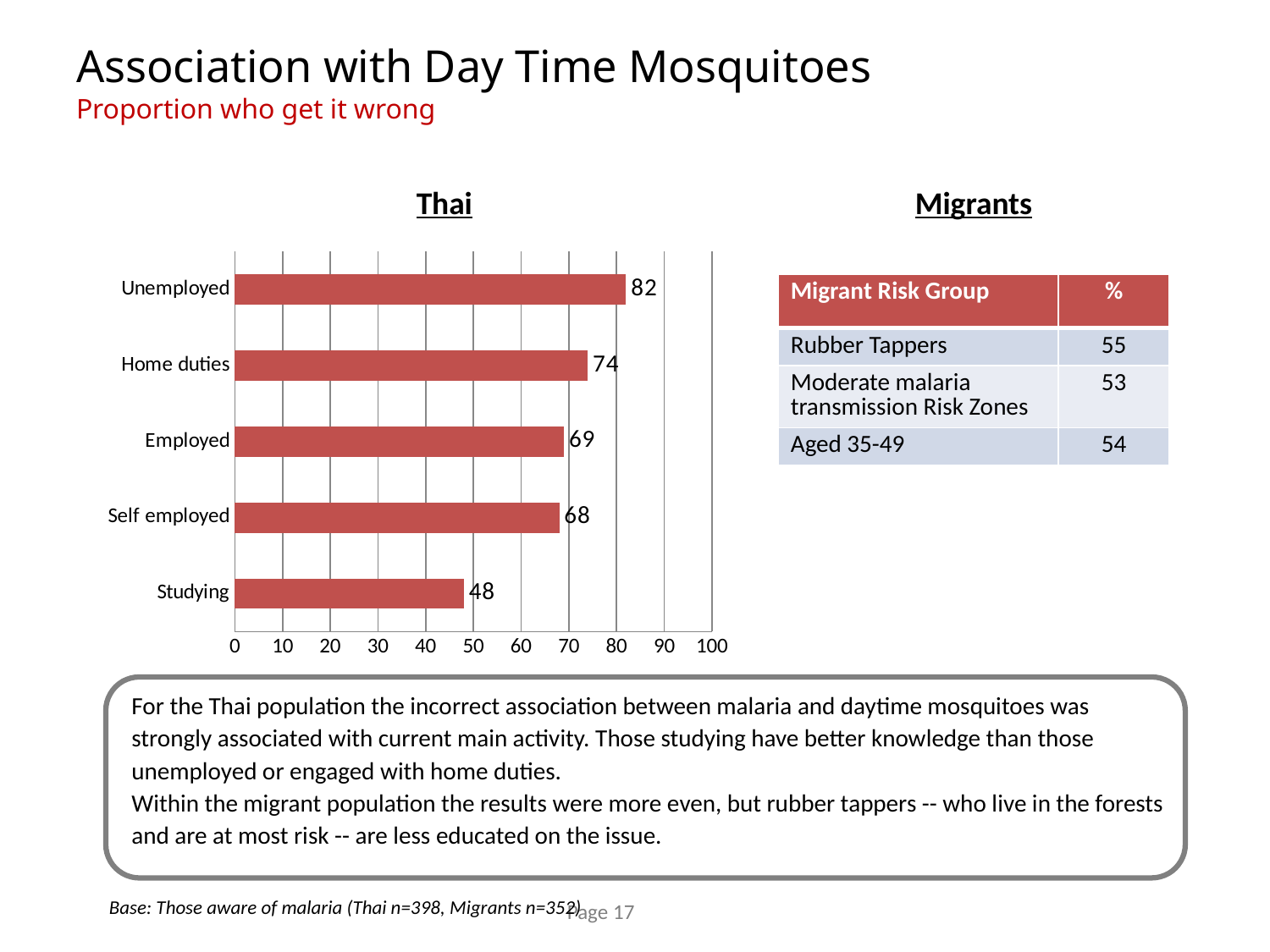
In the Thai chart, which category has the highest value? Unemployed What kind of chart is the Thai chart? Bar chart What is the maximum value shown on the x axis of the Thai chart? 100 In the Thai chart, which is larger, the value for Home duties or the value for Self employed? Home duties In the Thai chart, what is the value for Unemployed? 82 In the Thai chart, what is the value for Studying? 48 In the Thai chart, is the value for Employed greater or less than 60? greater How many categories are shown in the Thai chart? 5 In the Thai chart, what is the value for Home duties? 74 In the Thai chart, which category has the lowest value? Studying In the Thai chart, what is the difference between the values for Unemployed and Studying? 34 In the Thai chart, what is the difference between the values for Home duties and Employed? 5